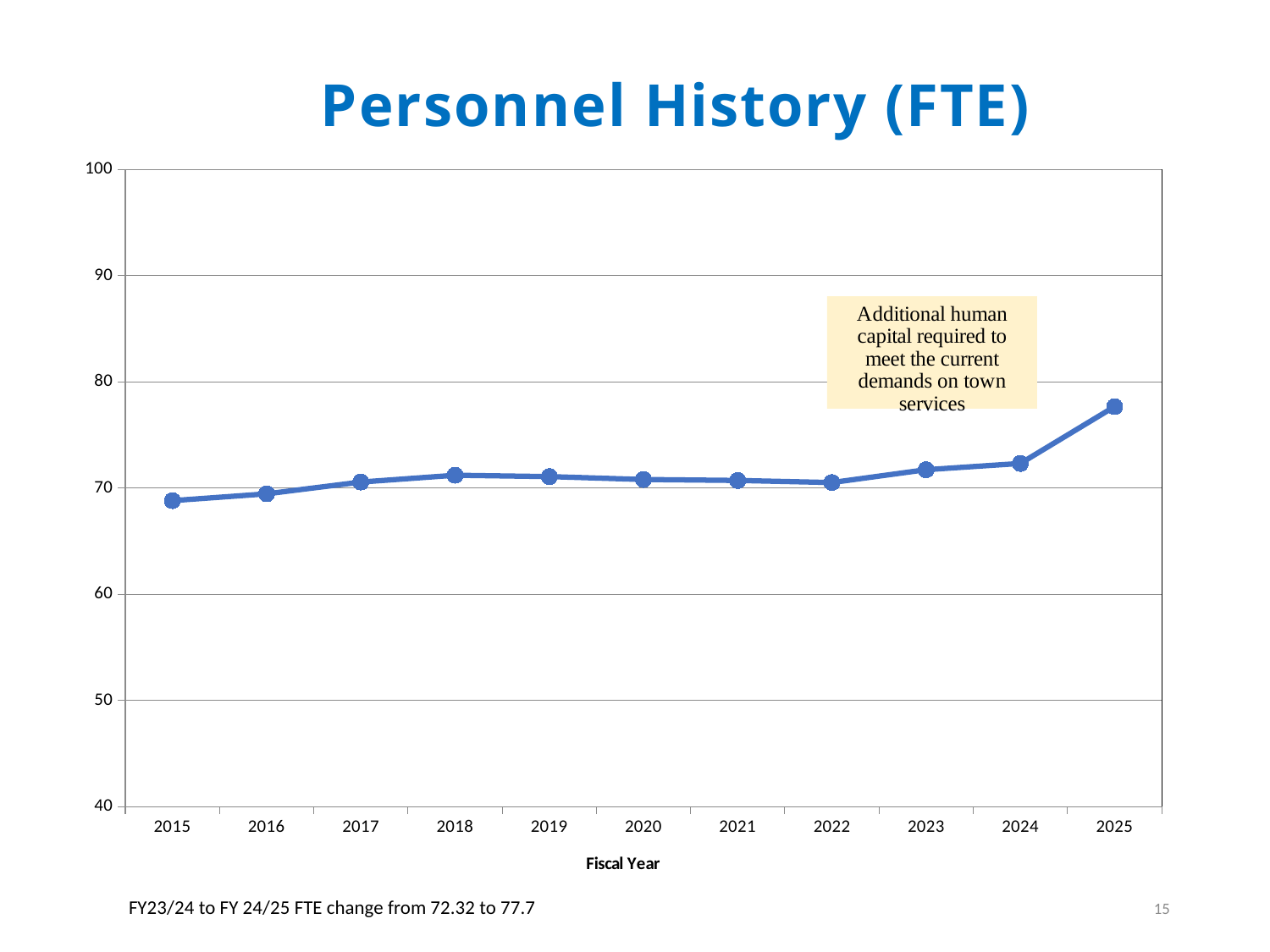
How many fiscal years are plotted on the chart? 11 What is the title of the x axis? Fiscal Year What kind of chart is shown on the slide? line chart Is the value for 2025 greater or less than 70? greater Which has the larger FTE value, 2016 or 2024? 2024 Overall, do the FTE values rise or fall from 2015 to 2025? rise Which fiscal year has the lowest FTE value? 2015 Which fiscal year has the highest FTE value? 2025 According to the note below the chart, what is the FTE for FY 24/25? 77.7 Is the value for 2020 greater or less than 80? less Is the value for 2015 greater or less than 70? less According to the note below the chart, by how much did FTE change from FY23/24 (72.32) to FY 24/25 (77.7)? 5.38